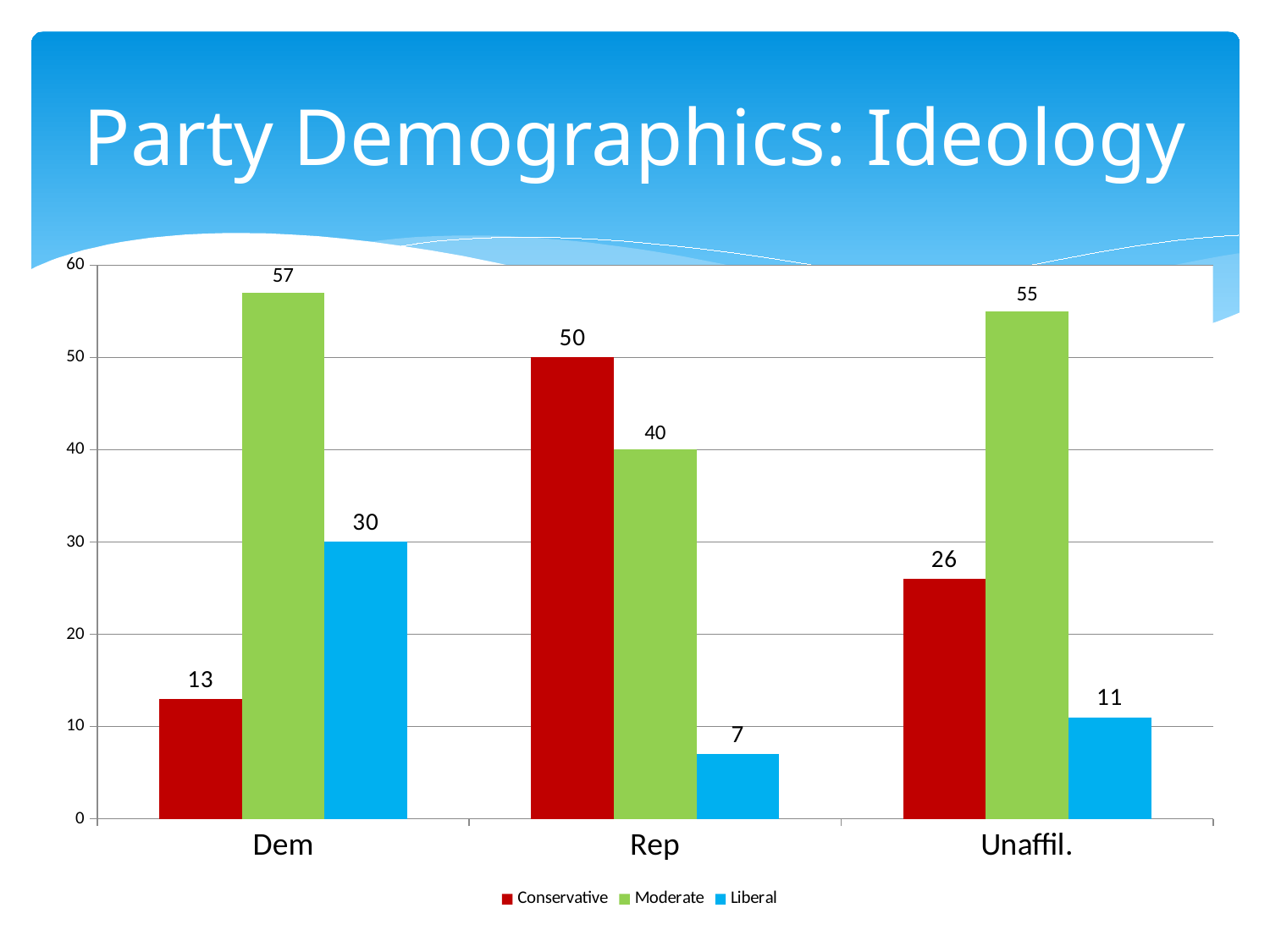
What is the title of the slide? Party Demographics: Ideology What is the Liberal value for Rep? 7 Which category has the lowest Liberal value? Rep Which colour represents the Moderate series? Green How many series does the legend list? 3 What is the difference between the Moderate values for Dem and Rep? 17 Which is larger, the Liberal value for Dem or the Liberal value for Unaffil.? Dem What kind of chart is shown on the slide? Bar chart What is the Moderate value for Dem? 57 What is the Conservative value for Unaffil.? 26 Which category has the highest Conservative value? Rep How many categories are shown on the x axis? 3